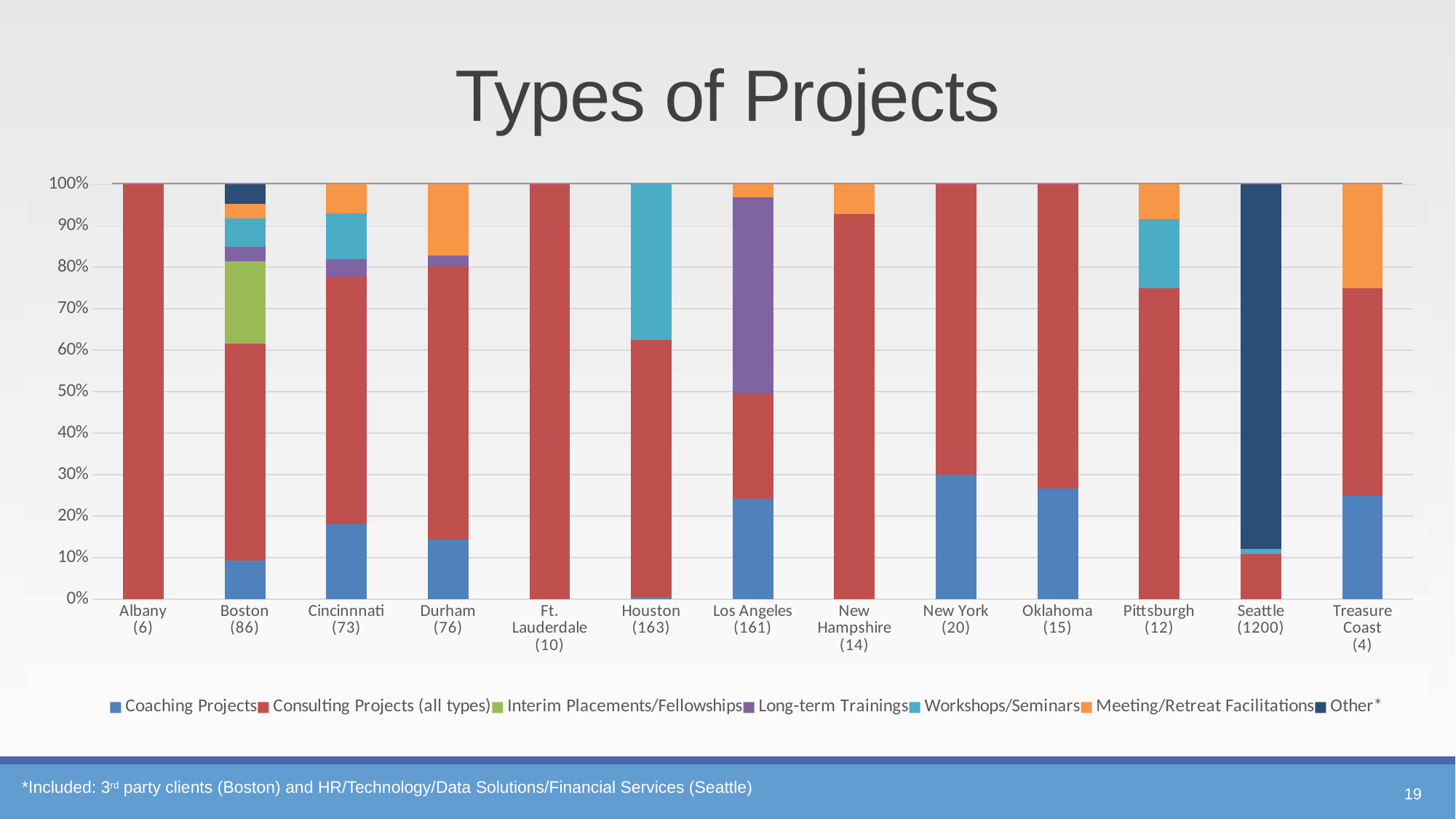
Is the Other* share for Seattle greater or less than 80%? greater What number appears in parentheses under the Seattle label? 1200 Which city has the largest Workshops/Seminars share? Houston What is the total height of the Albany stacked bar? 100% What kind of chart is shown on the slide? stacked bar chart Which city has the largest Long-term Trainings share? Los Angeles How many cities (categories) are shown along the x axis? 13 What is the title of the chart? Types of Projects Is the Coaching Projects share for Cincinnnati greater or less than 20%? less Which is larger, the Other* share for Seattle or the Other* share for Boston? Seattle How many series does the legend list? 7 Is the Workshops/Seminars share for Houston greater or less than 30%? greater